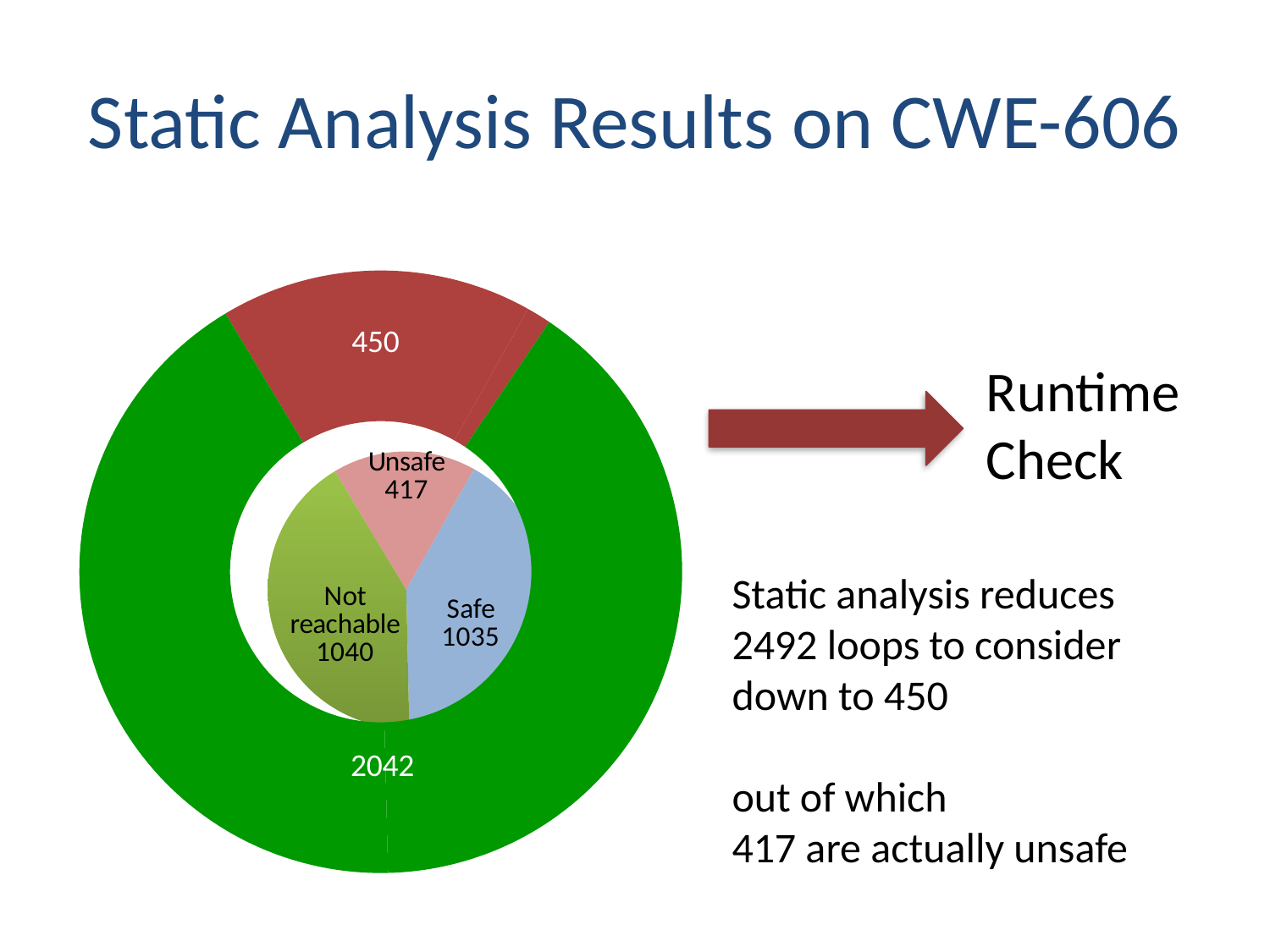
In the inner pie chart, which is larger, Safe or Not reachable? Not reachable How many slices does the inner pie chart have? 3 In the inner pie chart, what is the value for Unsafe? 417 What is the total of the three values in the inner pie chart? 2492 In the inner pie chart, what is the value for Safe? 1035 What is the title of the slide containing the chart? Static Analysis Results on CWE-606 In the inner pie chart, what is the value for Not reachable? 1040 In the outer ring, what is the difference between the green segment (2042) and the red segment (450)? 1592 In the inner pie chart, which category has the smallest value? Unsafe In the inner pie chart, what is the difference between Not reachable and Unsafe? 623 In the outer ring, what value is printed on the green segment? 2042 In the outer ring, what value is printed on the red segment? 450